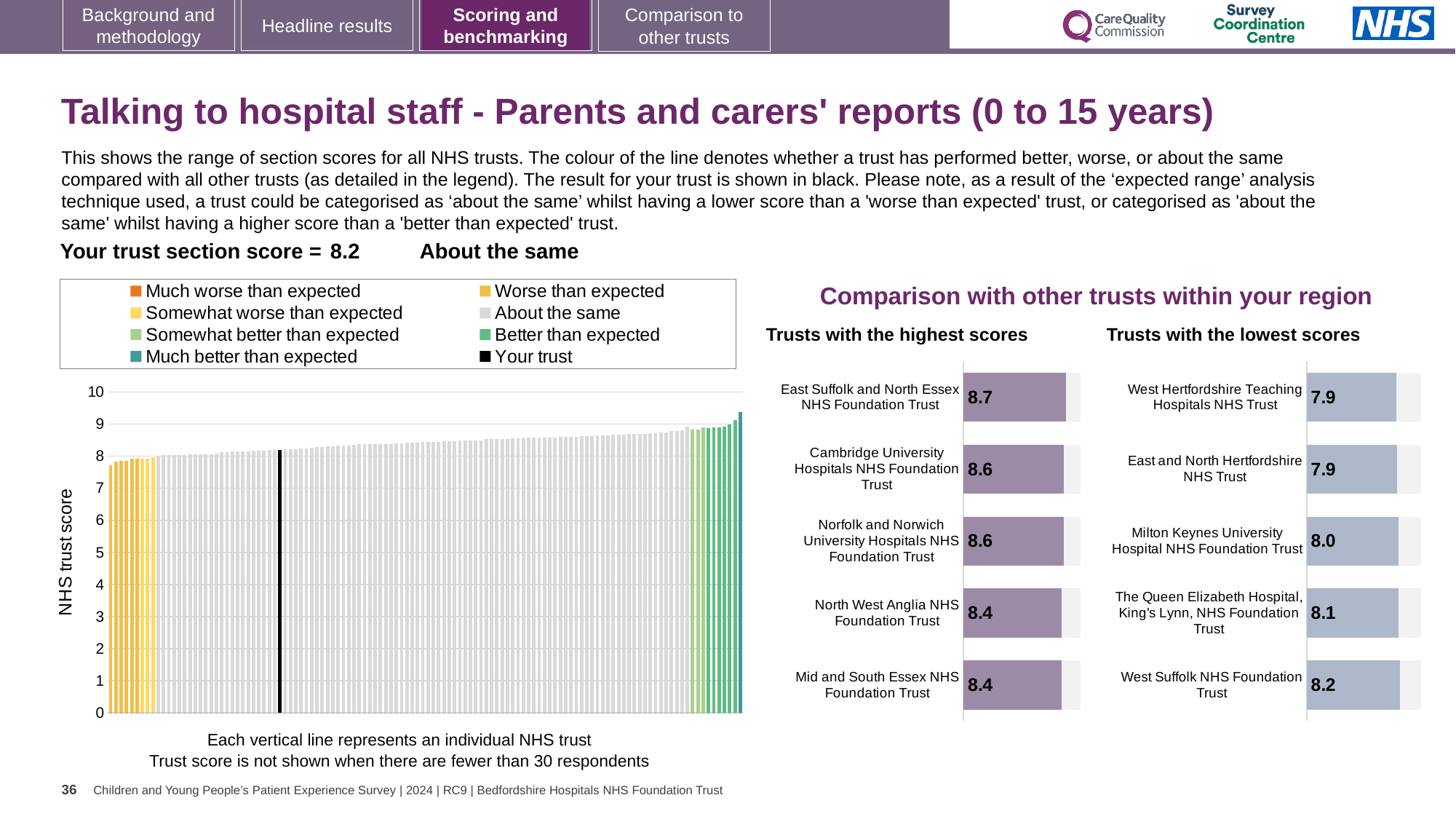
In the 'NHS trust score' chart, what colour is used for 'Your trust'? black In the 'NHS trust score' chart, is the value of the tallest bar greater or less than 9? greater In the 'Trusts with the highest scores' chart, which trust has the highest score? East Suffolk and North Essex NHS Foundation Trust What kind of chart is the 'NHS trust score' chart on the left of the slide? bar chart In the 'Trusts with the lowest scores' chart, what is the score for Milton Keynes University Hospital NHS Foundation Trust? 8.0 In the 'Trusts with the lowest scores' chart, which trust has the highest score? West Suffolk NHS Foundation Trust In the 'Trusts with the highest scores' chart, what is the score for East Suffolk and North Essex NHS Foundation Trust? 8.7 In the 'Trusts with the lowest scores' chart, which is larger: the score for The Queen Elizabeth Hospital, King's Lynn, NHS Foundation Trust or the score for West Hertfordshire Teaching Hospitals NHS Trust? The Queen Elizabeth Hospital, King's Lynn, NHS Foundation Trust How many entries does the legend above the 'NHS trust score' chart list? 8 In the 'NHS trust score' chart on the left, do the bars rise or fall from left to right? rise In the 'Trusts with the highest scores' chart, how many trusts are shown? 5 In the 'Trusts with the highest scores' chart, what is the difference between the scores of East Suffolk and North Essex NHS Foundation Trust and Mid and South Essex NHS Foundation Trust? 0.3